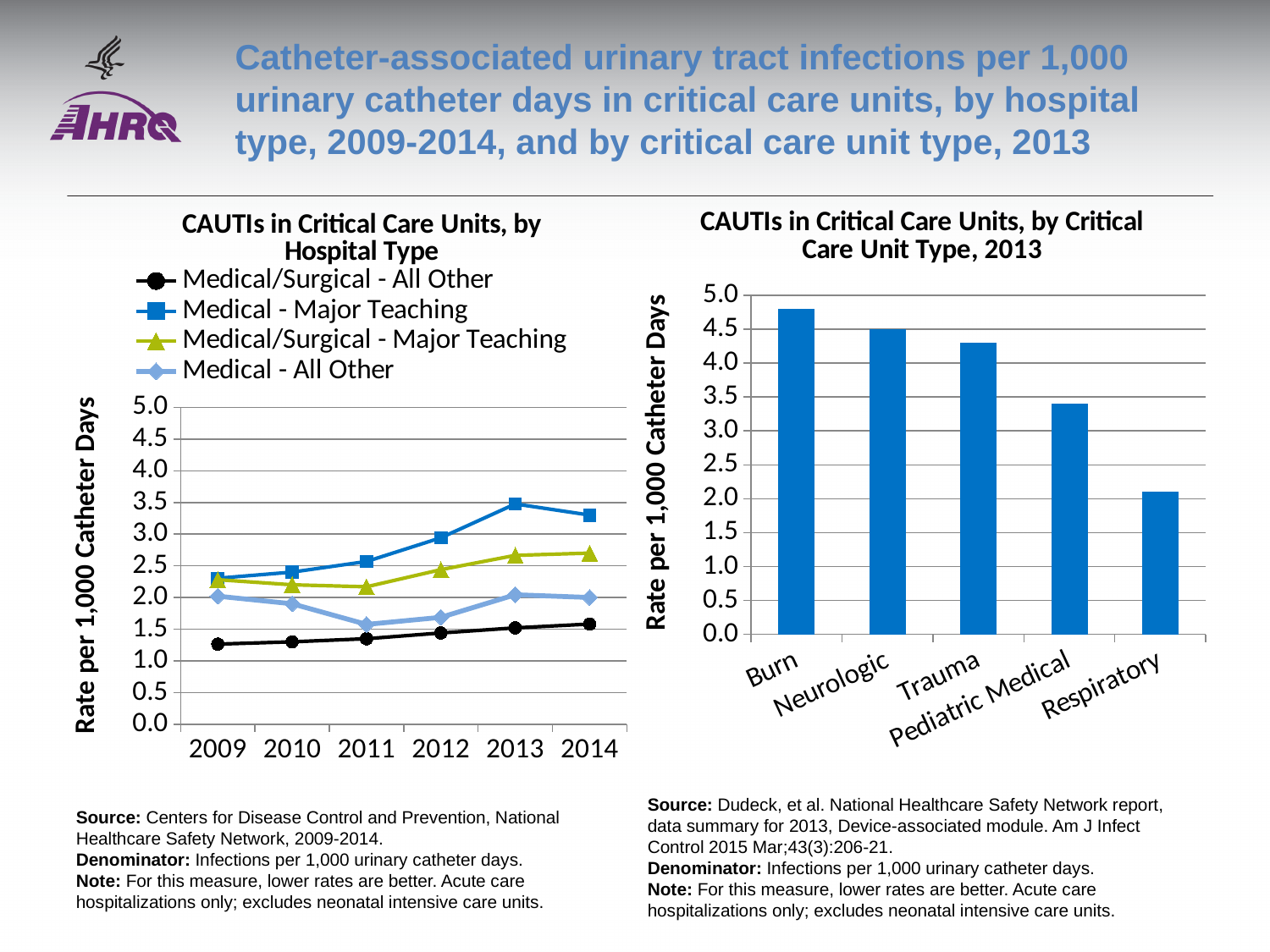
In the chart titled 'CAUTIs in Critical Care Units, by Critical Care Unit Type, 2013', is the value for Burn greater or less than 4.5? greater In the chart titled 'CAUTIs in Critical Care Units, by Critical Care Unit Type, 2013', which is larger, the value for Trauma or the value for Pediatric Medical? Trauma In the chart titled 'CAUTIs in Critical Care Units, by Hospital Type', does the rate for Medical/Surgical - All Other rise or fall from 2009 to 2014? rise In the chart titled 'CAUTIs in Critical Care Units, by Critical Care Unit Type, 2013', which critical care unit type has the highest rate? Burn In the chart titled 'CAUTIs in Critical Care Units, by Critical Care Unit Type, 2013', is the value for Respiratory greater or less than 2.5? less In the chart titled 'CAUTIs in Critical Care Units, by Critical Care Unit Type, 2013', which critical care unit type has the lowest rate? Respiratory What kind of chart is the one titled 'CAUTIs in Critical Care Units, by Critical Care Unit Type, 2013'? bar chart In the chart titled 'CAUTIs in Critical Care Units, by Hospital Type', how many series does the legend list? 4 In the chart titled 'CAUTIs in Critical Care Units, by Hospital Type', is the value for Medical - Major Teaching in 2013 greater or less than 3.0? greater In the chart titled 'CAUTIs in Critical Care Units, by Hospital Type', which hospital type has the highest rate in 2013? Medical - Major Teaching In the chart titled 'CAUTIs in Critical Care Units, by Critical Care Unit Type, 2013', how many critical care unit types are shown? 5